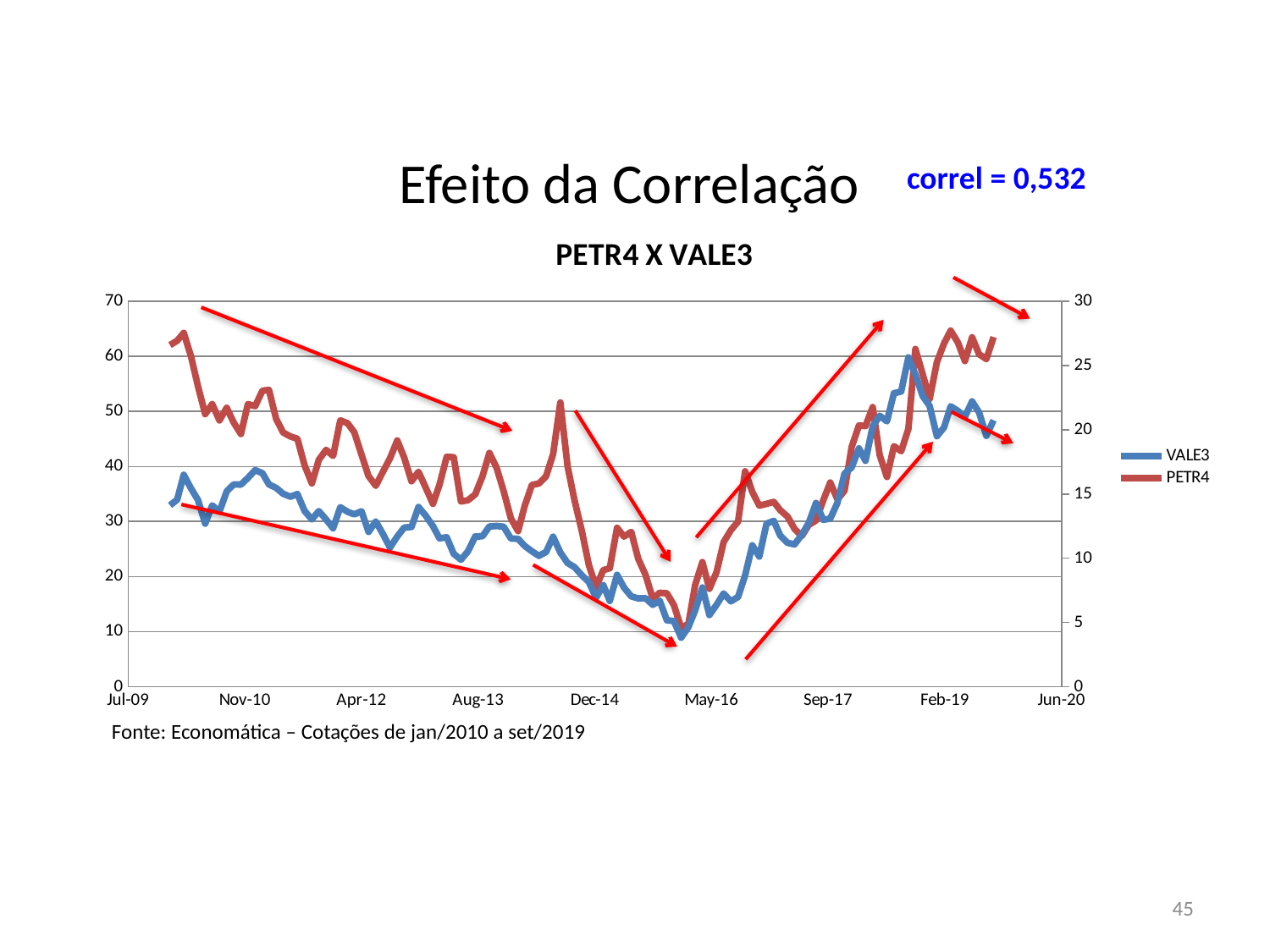
How many series does the legend list? 2 What is the title of the chart? PETR4 X VALE3 Does the PETR4 series generally rise or fall between May-16 and Feb-19? rise Is the value for PETR4 at the start of the series (early 2010) greater or less than 20 on the right axis? greater What kind of chart is shown on the slide? line chart Is the lowest value for PETR4 (around early 2016) greater or less than 10 on the right axis? less Is the lowest value for VALE3 (around early 2016) greater or less than 20 on the left axis? less Does the VALE3 series generally rise or fall between Nov-10 and Dec-14? fall What correlation value (correl) is printed on the slide? 0,532 Does the VALE3 series generally rise or fall between May-16 and Feb-19? rise